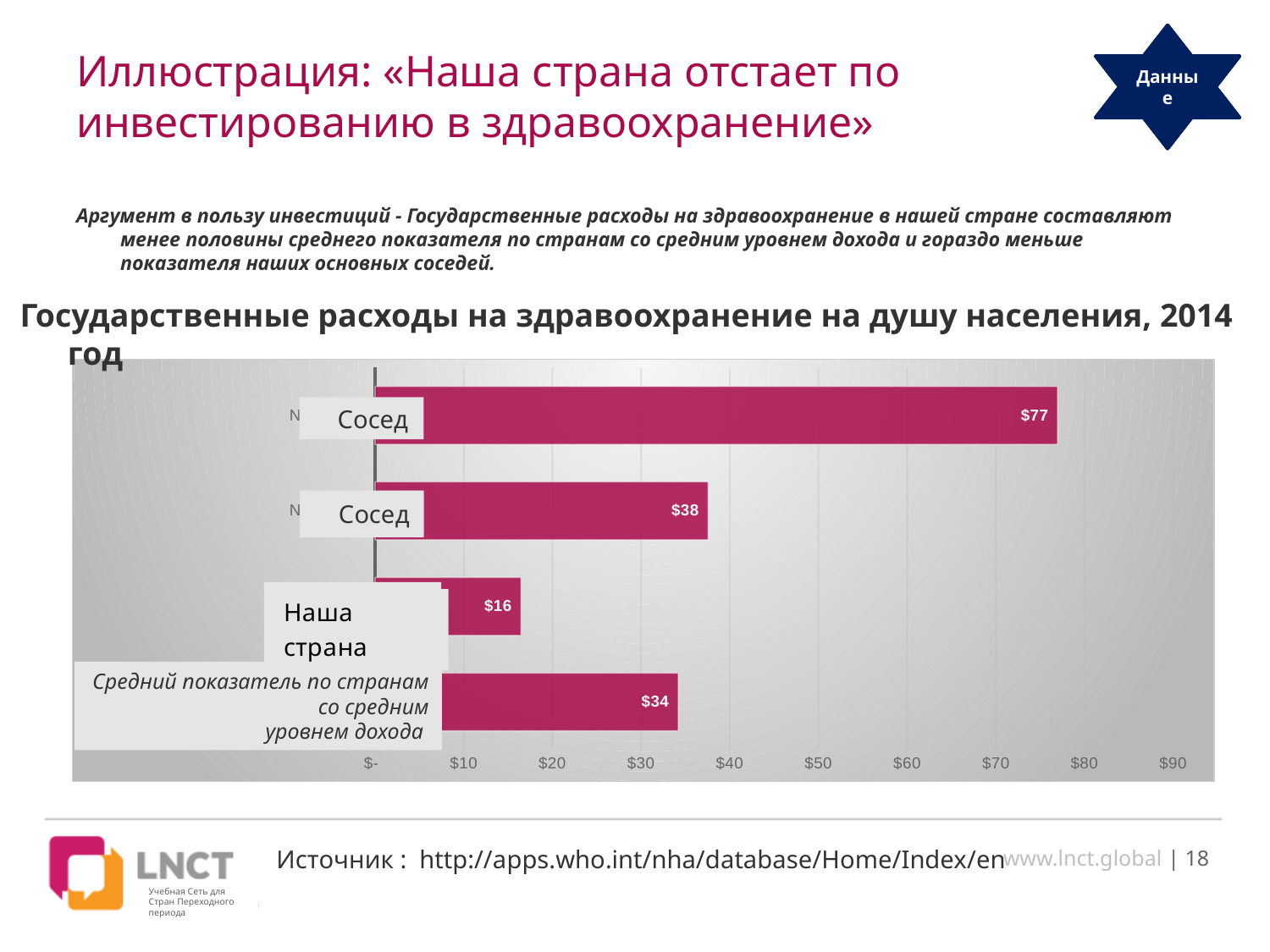
Which category has the lowest value? Наша страна What type of chart is shown on the slide? bar chart What is the value for "Средний показатель по странам со средним уровнем дохода"? $34 What is the difference between the two "Сосед" bars? $39 What is the value of the topmost bar, labelled "Сосед"? $77 What is the difference between the value for "Средний показатель по странам со средним уровнем дохода" and the value for "Наша страна"? $18 What is the highest value shown in the chart? $77 Which is larger: the value for "Наша страна" or the value for "Средний показатель по странам со средним уровнем дохода"? Средний показатель по странам со средним уровнем дохода How many bars are plotted in the chart? 4 What is the value of the second bar from the top, labelled "Сосед"? $38 What is the value for "Наша страна"? $16 What is the title of the chart? Государственные расходы на здравоохранение на душу населения, 2014 год